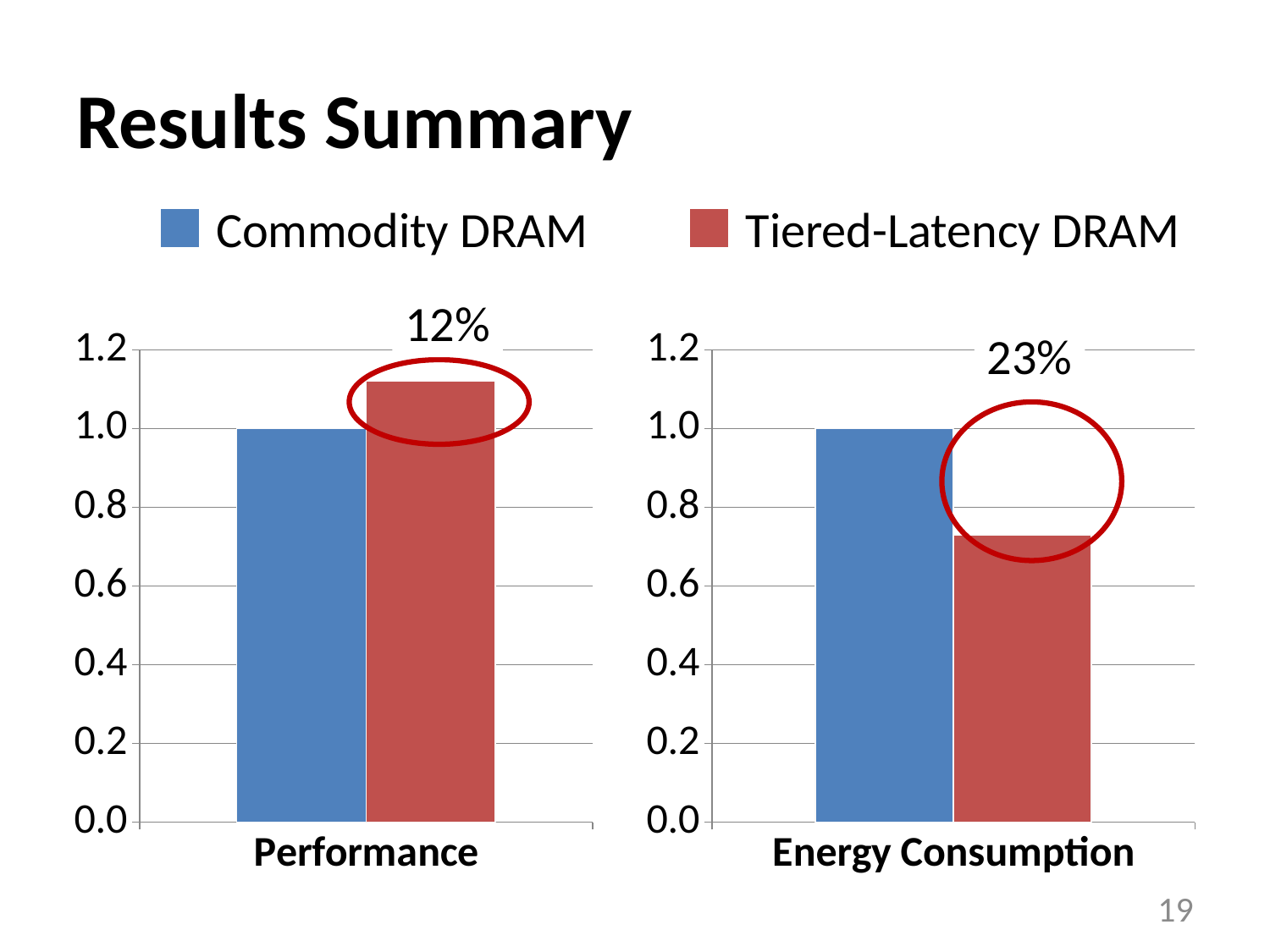
What percentage is annotated above the Tiered-Latency DRAM bar in the Energy Consumption chart? 23% In the Performance chart, which series has the higher bar, Commodity DRAM or Tiered-Latency DRAM? Tiered-Latency DRAM In the Energy Consumption chart, which series has the lower bar, Commodity DRAM or Tiered-Latency DRAM? Tiered-Latency DRAM In the Performance chart, is the value for Tiered-Latency DRAM greater or less than 1.0? greater What kind of chart is the Performance chart? Bar chart How many series does the legend list? 2 In the Energy Consumption chart, what is the value for Commodity DRAM? 1.0 What is the highest value shown on the y axis of the Energy Consumption chart? 1.2 In the Performance chart, what is the value for Commodity DRAM? 1.0 In the Energy Consumption chart, is the value for Tiered-Latency DRAM greater or less than 1.0? less In the Energy Consumption chart, is the value for Tiered-Latency DRAM greater or less than 0.8? less What percentage is annotated above the Tiered-Latency DRAM bar in the Performance chart? 12%